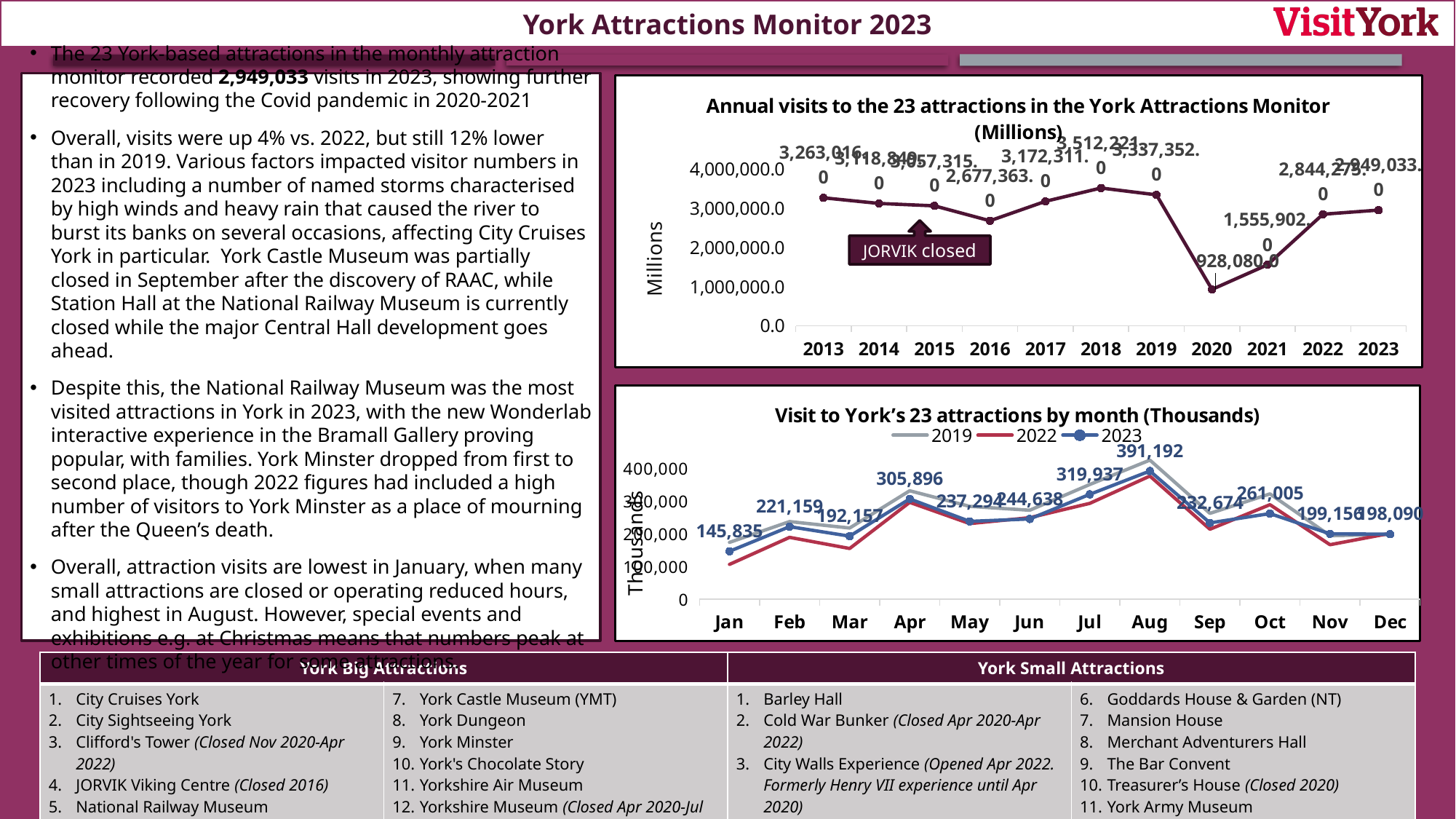
How many series does the legend of the 'Visit to York's 23 attractions by month (Thousands)' chart list? 3 In the 'Annual visits' chart, what is the value for 2020? 928,080.0 In the 'Annual visits' chart, what is the difference between the 2023 value and the 2021 value? 1,393,131.0 In the 'Visit to York's 23 attractions by month' chart, which month has the lowest 2023 value? Jan What kind of chart is the 'Annual visits to the 23 attractions in the York Attractions Monitor' chart? line chart In the 'Annual visits' chart, how many years are plotted on the x axis? 11 In the 'Visit to York's 23 attractions by month' chart, what is the 2023 value for Aug? 391,192 In the 'Annual visits' chart, is the value for 2021 greater or less than 2,000,000.0? less In the 'Annual visits' chart, which year has the lowest value? 2020 In the 'Visit to York's 23 attractions by month' chart, what is the difference between the 2023 values for Aug and Jan? 245,357 In the 'Annual visits' chart, which year has the highest value? 2018 In the 'Annual visits' chart, what is the value for 2018? 3,512,221.0